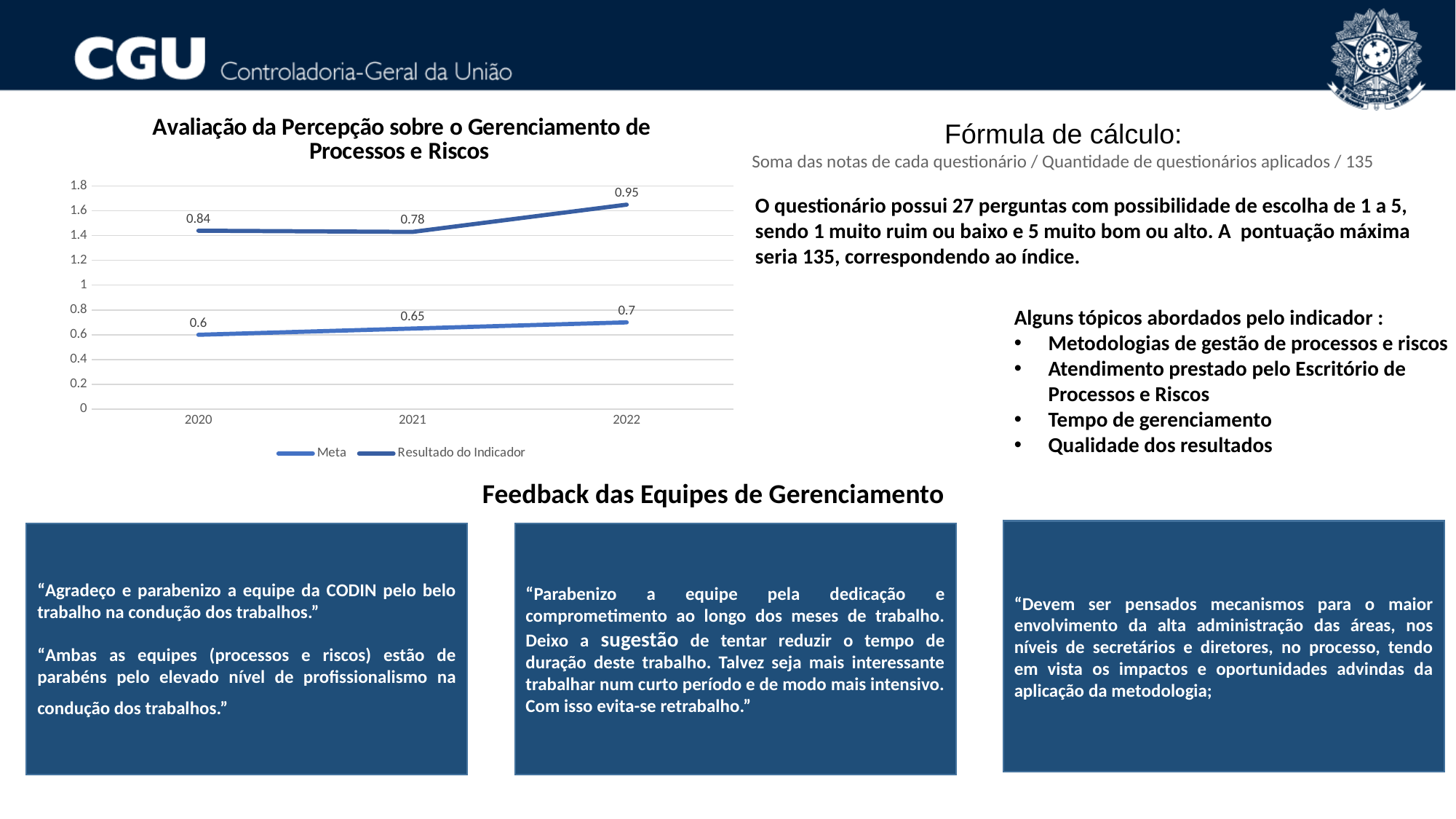
How many years are shown on the x axis? 3 What is the value of Resultado do Indicador in 2022? 0.95 In which year is Meta highest? 2022 Does the Meta series rise or fall from 2020 to 2022? rise What is the difference between Resultado do Indicador and Meta in 2022? 0.25 What is the value of Meta in 2021? 0.65 What is the value of Meta in 2022? 0.7 What is the value of Resultado do Indicador in 2020? 0.84 Which is larger in 2020, Meta or Resultado do Indicador? Resultado do Indicador What type of chart is shown on the slide? line chart How many series does the legend list? 2 In which year is Resultado do Indicador lowest? 2021